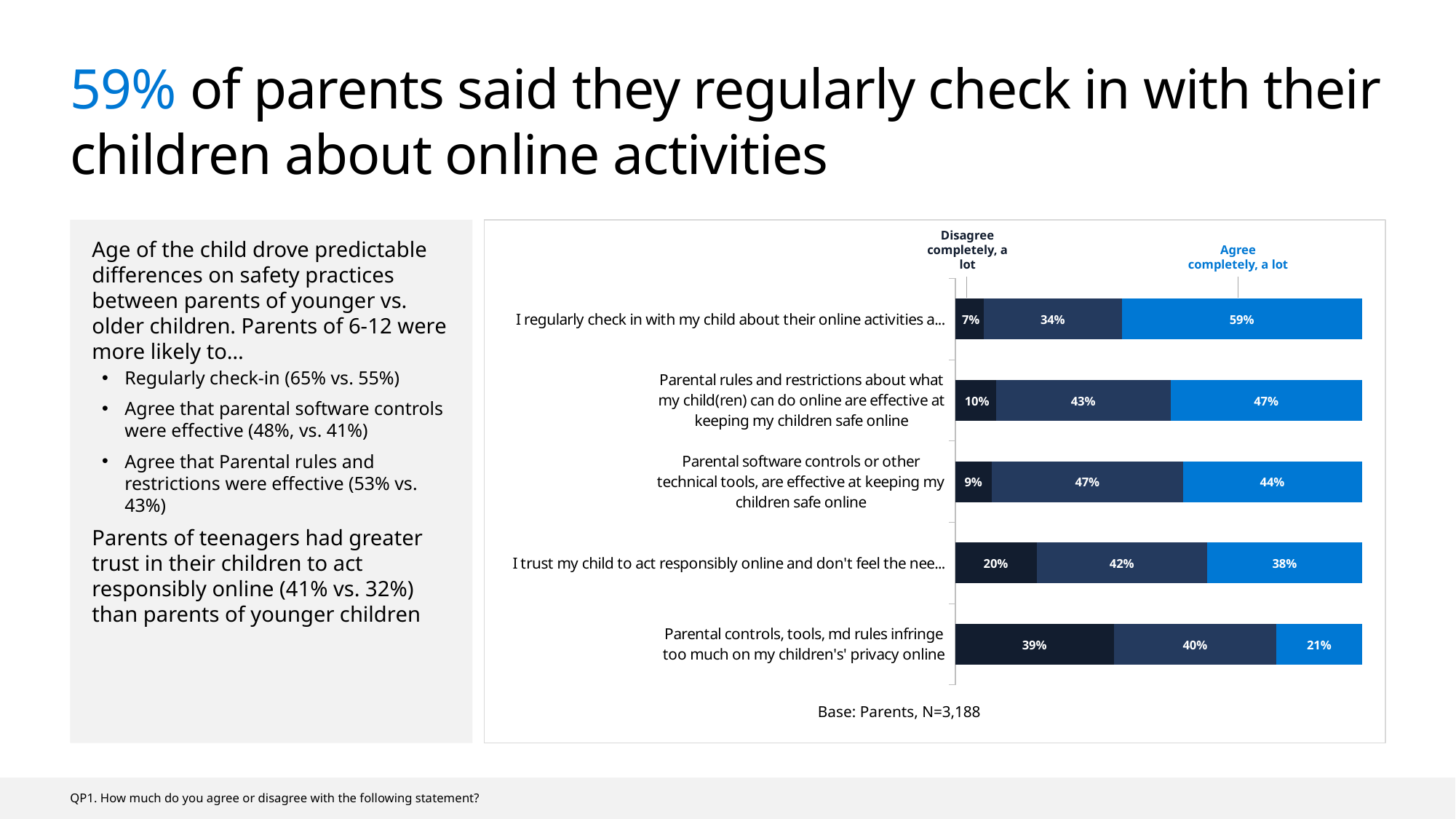
How many statements are shown in the chart? 5 What type of chart is shown on the slide? Stacked horizontal bar chart Which statement has the lowest 'Agree completely, a lot' percentage? Parental controls, tools, and rules infringe too much on my children's privacy online What percentage of parents disagree completely or a lot that parental controls, tools, and rules infringe too much on their children's privacy online? 39% Which is larger: the 'Disagree completely, a lot' share for the privacy-infringement statement or for the trust statement? The privacy-infringement statement (39%) What percentage of parents agree completely or a lot that they regularly check in with their child about their online activities? 59% What is the total of the three segments in the bar for 'Parental rules and restrictions about what my child(ren) can do online are effective at keeping my children safe online'? 100% What is the difference between the 'Agree completely, a lot' percentages for regularly checking in (59%) and for parental rules being effective (47%)? 12 percentage points What is the 'Agree completely, a lot' value for the statement that parental software controls or other technical tools are effective at keeping children safe online? 44% What is the base size stated below the chart? Parents, N=3,188 Which statement has the highest 'Agree completely, a lot' percentage? I regularly check in with my child about their online activities What is the 'Disagree completely, a lot' value for the statement 'I trust my child to act responsibly online and don't feel the need...'? 20%